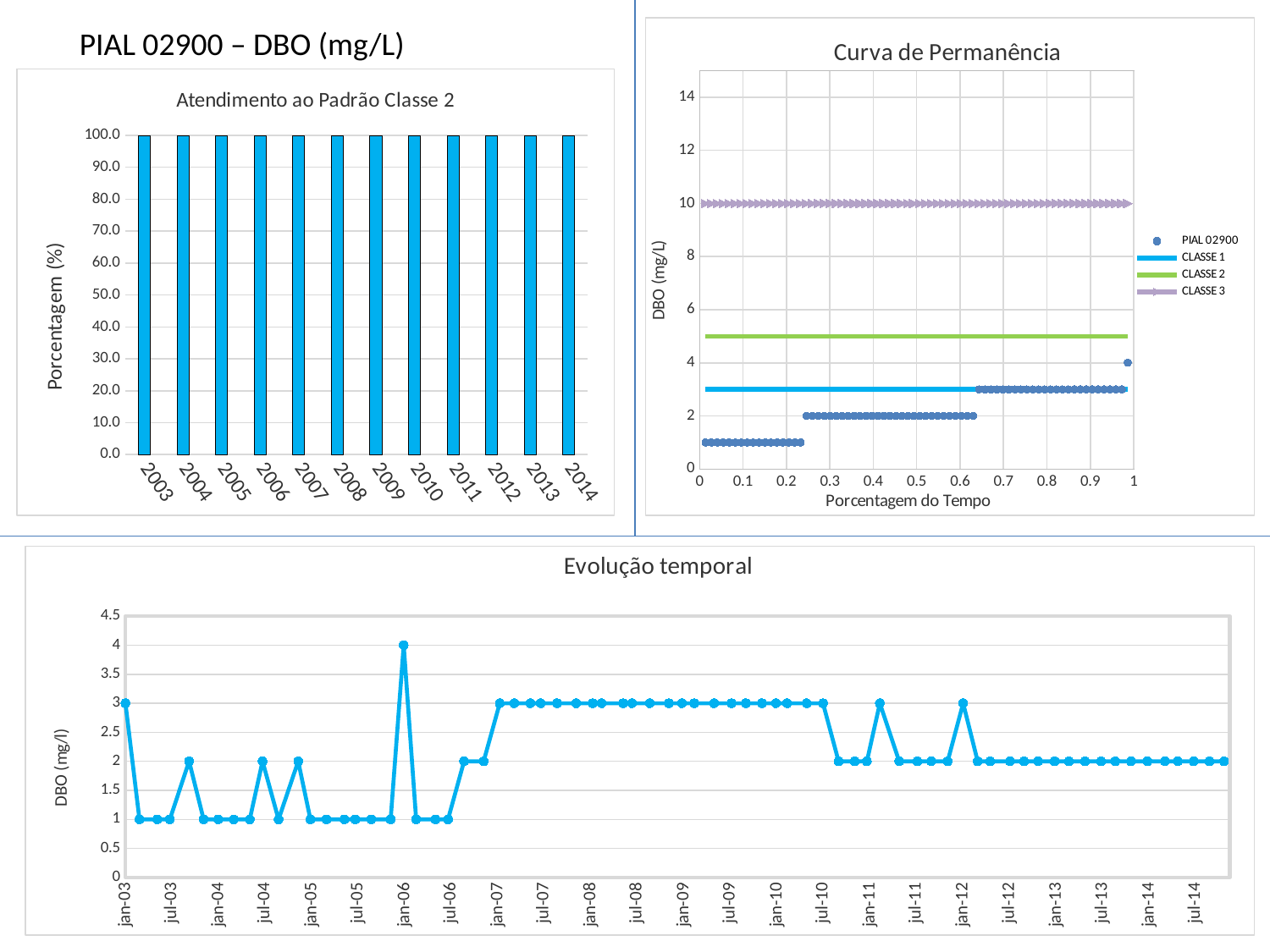
What kind of chart is 'Evolução temporal'? Line chart In the 'Atendimento ao Padrão Classe 2' chart, what is the value for 2010? 100.0 How many years (bars) are shown in the 'Atendimento ao Padrão Classe 2' chart? 12 In the 'Curva de Permanência' chart, is the CLASSE 2 line greater or less than 4 mg/L? greater In the 'Atendimento ao Padrão Classe 2' chart, do the values rise, fall or stay constant from 2003 to 2014? Stay constant In the 'Evolução temporal' chart, which is larger: the peak value near jan-06 or the value at jan-07? The peak near jan-06 In the 'Evolução temporal' chart, what is the highest DBO value reached? 4 What is the x-axis label of the 'Curva de Permanência' chart? Porcentagem do Tempo In the 'Curva de Permanência' chart, which of the class lines (CLASSE 1, CLASSE 2, CLASSE 3) is the highest? CLASSE 3 How many series does the legend of the 'Curva de Permanência' chart list? 4 In the 'Curva de Permanência' chart, at what DBO (mg/L) value does the CLASSE 3 line sit? 10 What kind of chart is 'Atendimento ao Padrão Classe 2'? Bar chart